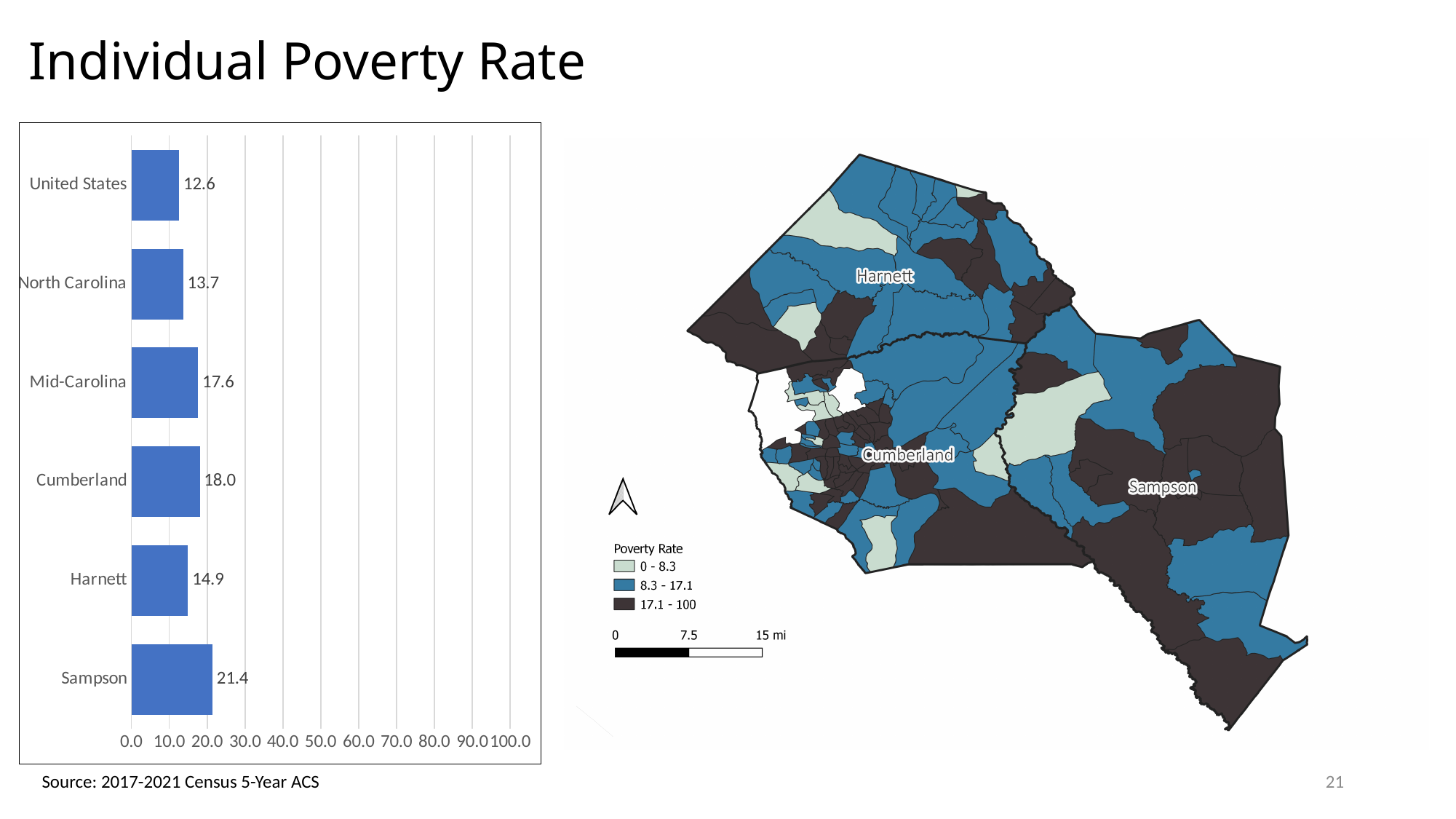
What is the individual poverty rate for Sampson in the bar chart? 21.4 How many categories are shown in the bar chart? 6 What kind of chart is shown on the left of the slide? Bar chart What is the individual poverty rate for Harnett in the bar chart? 14.9 What is the difference between the poverty rates of Cumberland and Harnett in the bar chart? 3.1 What is the individual poverty rate for the United States in the bar chart? 12.6 Which category has the lowest individual poverty rate in the bar chart? United States Is the value for Sampson in the bar chart greater or less than 20.0? greater What is the difference between the poverty rates of Sampson and the United States in the bar chart? 8.8 Which category has the highest individual poverty rate in the bar chart? Sampson In the bar chart, which has a higher poverty rate, Mid-Carolina or North Carolina? Mid-Carolina What is the individual poverty rate for Cumberland in the bar chart? 18.0